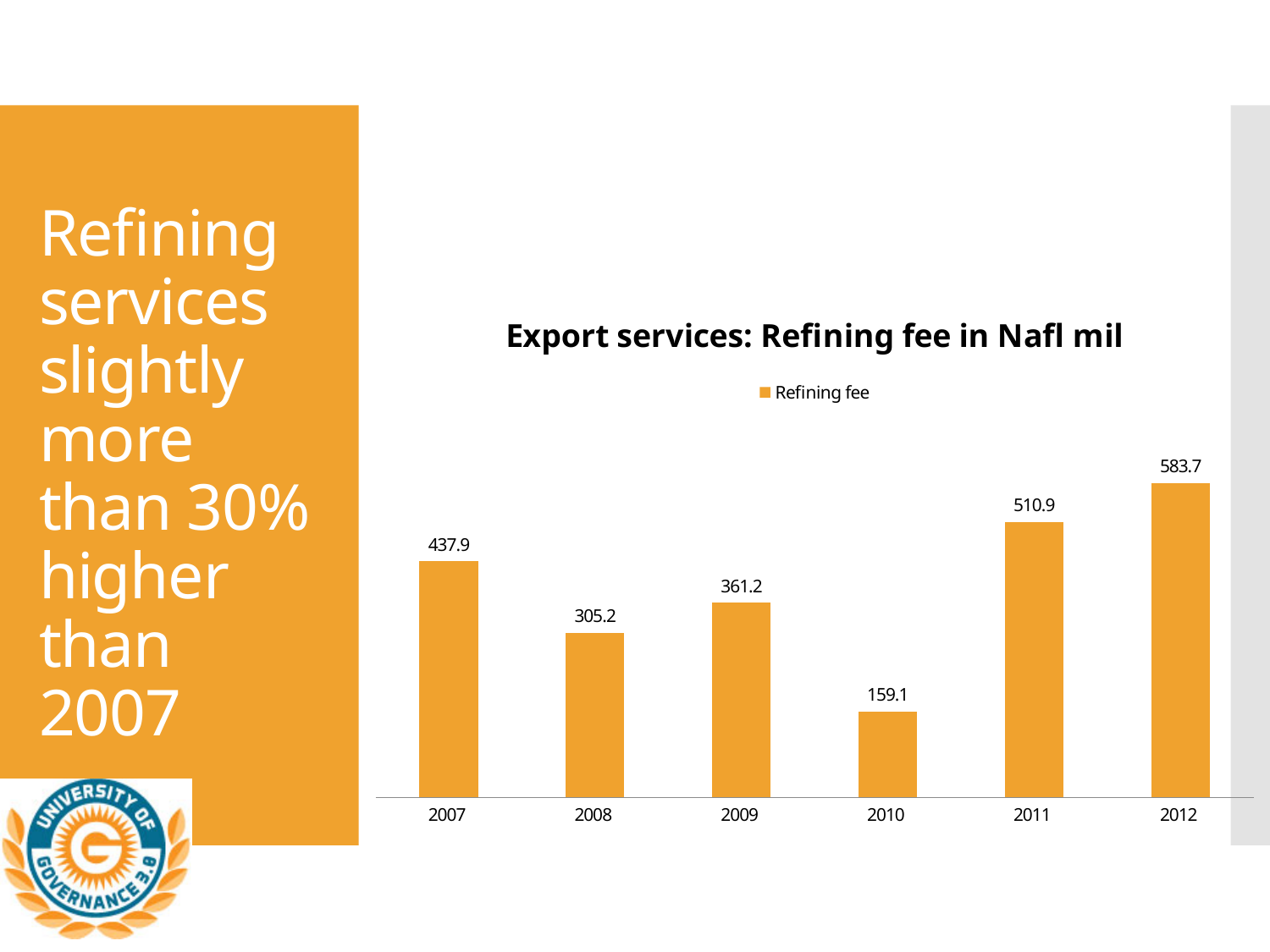
How many series does the legend list? 1 What is the title of the chart? Export services: Refining fee in Nafl mil Which year has the highest refining fee? 2012 Which year has the lowest refining fee? 2010 What is the refining fee for 2010? 159.1 How many years are shown on the x axis? 6 What is the refining fee for 2007? 437.9 What kind of chart is shown on the slide? Bar chart What is the difference between the refining fee in 2011 and in 2010? 351.8 Which year has a larger refining fee, 2008 or 2009? 2009 What is the refining fee for 2012? 583.7 What is the difference between the refining fee in 2012 and in 2007? 145.8